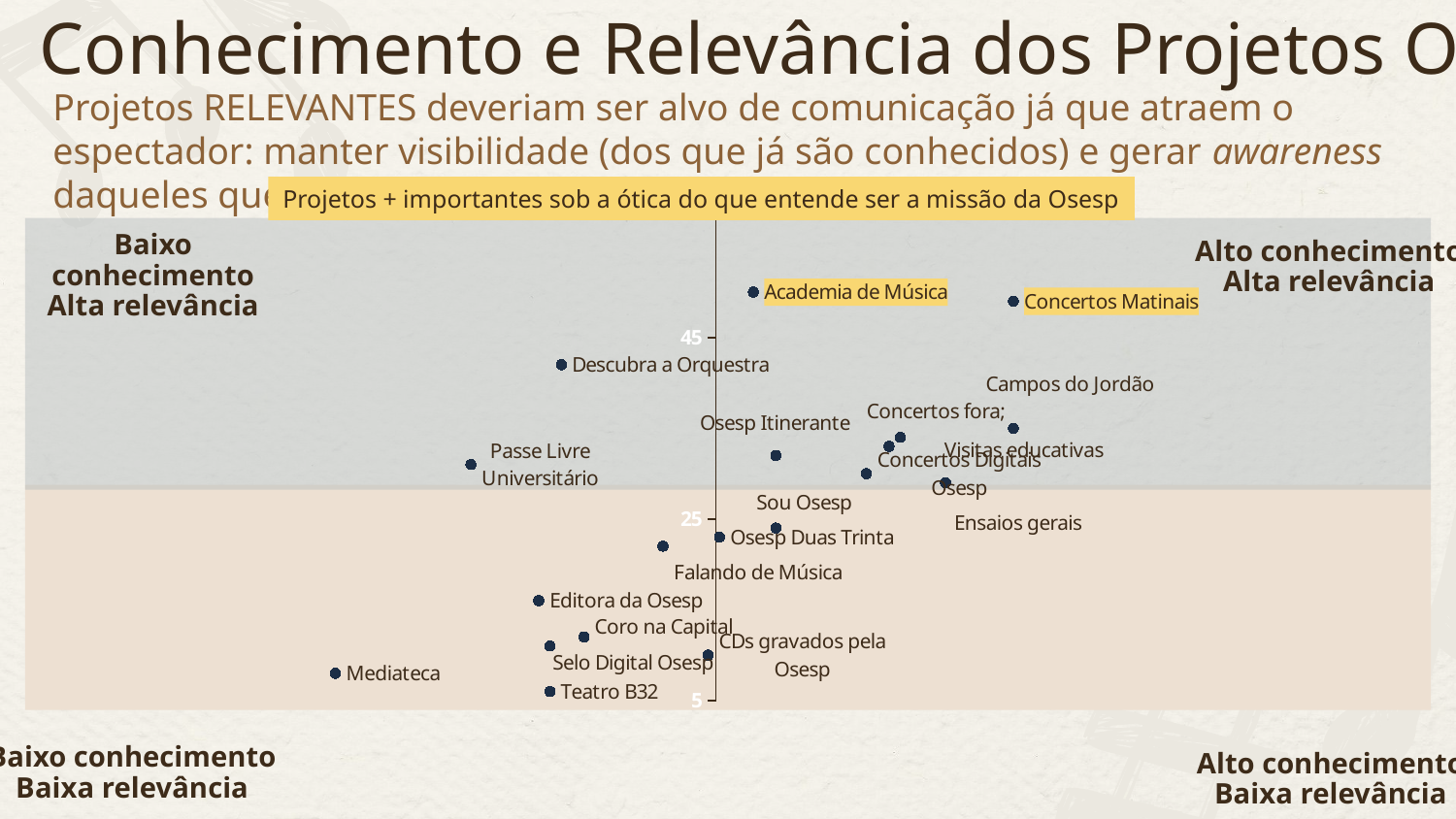
Which is plotted higher on the chart, Descubra a Orquestra or Editora da Osesp? Descubra a Orquestra What label describes the top-right quadrant of the chart? Alto conhecimento Alta relevância Which project is plotted furthest to the left on the chart? Mediateca Is the vertical value for Teatro B32 greater or less than 25? less Is the vertical value for Descubra a Orquestra greater or less than 45? less Is the vertical value for Passe Livre Universitário greater or less than 25? greater Which two project labels are highlighted in yellow on the chart? Academia de Música and Concertos Matinais What kind of chart is shown on the slide? Scatter chart Which project has the lowest vertical position on the chart? Teatro B32